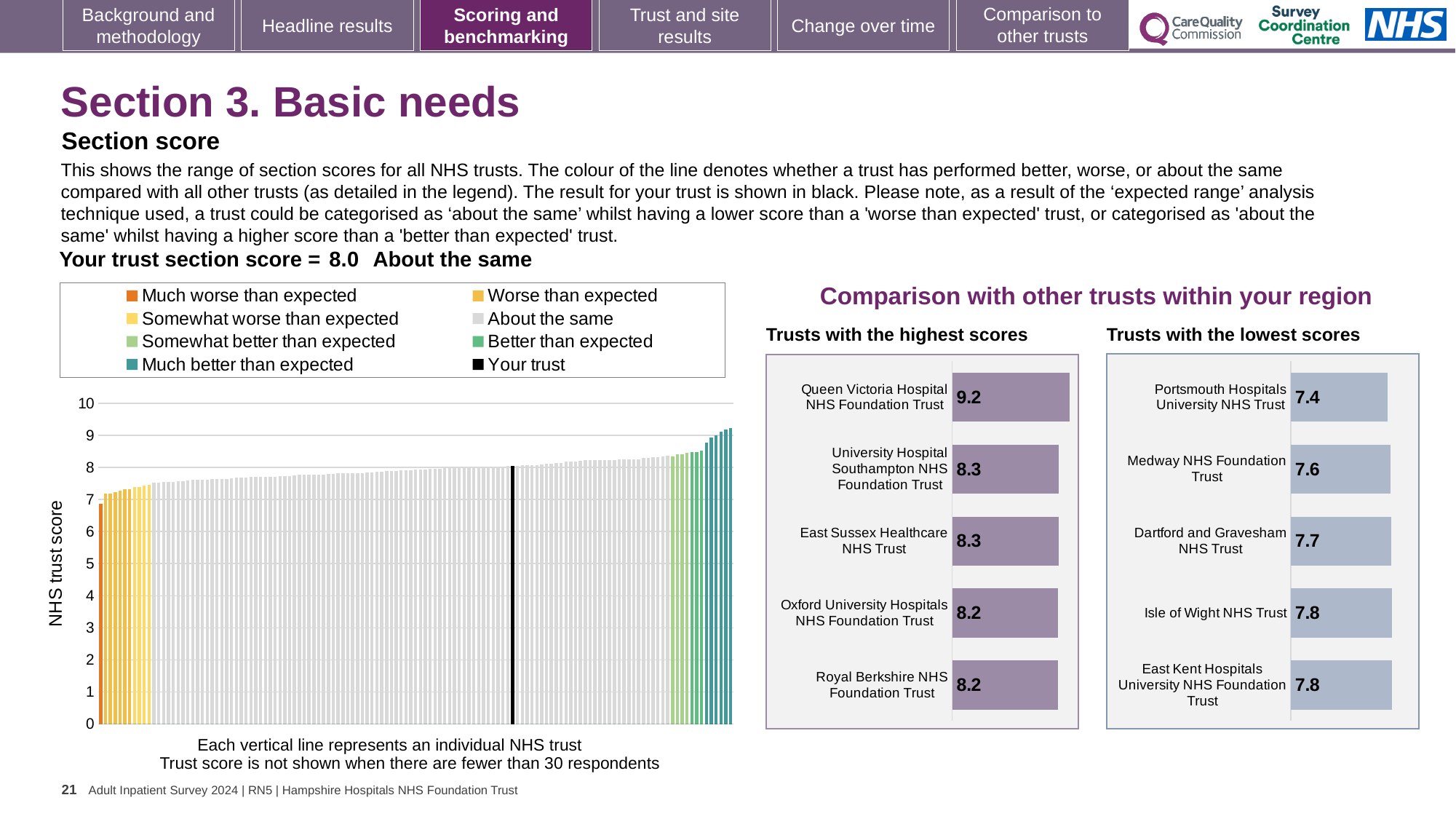
In the 'Trusts with the lowest scores' chart, what is the difference between the scores for Medway NHS Foundation Trust and Portsmouth Hospitals University NHS Trust? 0.2 In the 'Trusts with the lowest scores' chart, what is the score for Portsmouth Hospitals University NHS Trust? 7.4 In the 'Trusts with the highest scores' chart, which trust has the highest score? Queen Victoria Hospital NHS Foundation Trust How many trusts are shown in the 'Trusts with the highest scores' chart? 5 What kind of chart is the 'Trusts with the lowest scores' chart? Bar chart In the main NHS trust score chart, is the value of the tallest bar greater or less than 9? greater How many entries does the legend of the main NHS trust score chart list? 8 In the 'Trusts with the highest scores' chart, which has the larger score: Queen Victoria Hospital NHS Foundation Trust or Royal Berkshire NHS Foundation Trust? Queen Victoria Hospital NHS Foundation Trust In the 'Trusts with the lowest scores' chart, which trust has the lowest score? Portsmouth Hospitals University NHS Trust In the 'Trusts with the highest scores' chart, what is the score for Queen Victoria Hospital NHS Foundation Trust? 9.2 In the 'Trusts with the lowest scores' chart, what is the score for Dartford and Gravesham NHS Trust? 7.7 What is the difference between the score for Queen Victoria Hospital NHS Foundation Trust in the highest scores chart and the score for Portsmouth Hospitals University NHS Trust in the lowest scores chart? 1.8